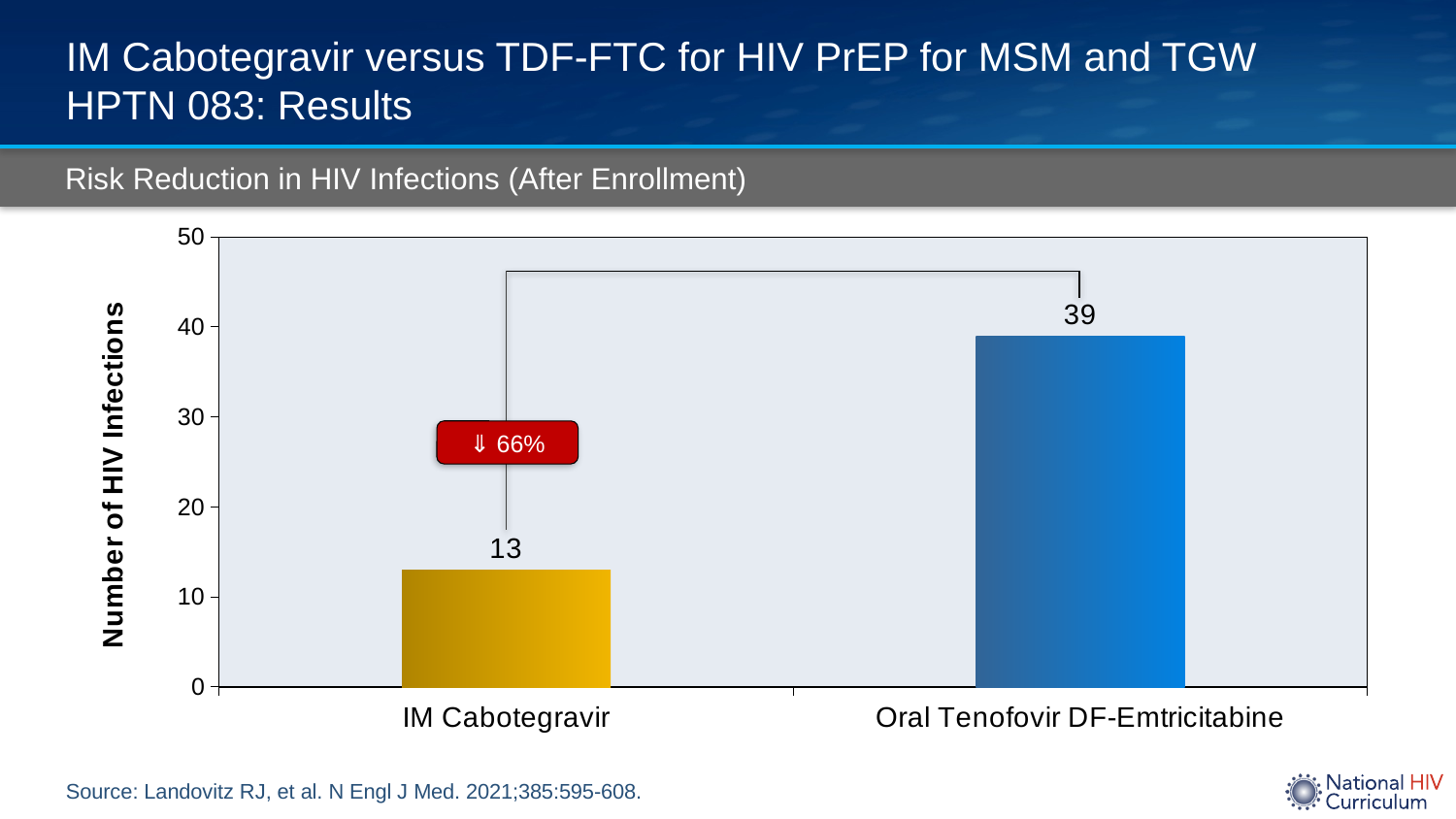
Is the number of HIV infections for IM Cabotegravir greater or less than 20? less What is the label of the y axis of the chart? Number of HIV Infections Which group had the highest number of HIV infections? Oral Tenofovir DF-Emtricitabine Which group had the lowest number of HIV infections? IM Cabotegravir Is the number of HIV infections for Oral Tenofovir DF-Emtricitabine greater or less than 30? greater What is the number of HIV infections for Oral Tenofovir DF-Emtricitabine? 39 What is the number of HIV infections for IM Cabotegravir? 13 How many categories are shown on the x axis of the chart? 2 What is the difference in the number of HIV infections between Oral Tenofovir DF-Emtricitabine and IM Cabotegravir? 26 Which had more HIV infections, IM Cabotegravir or Oral Tenofovir DF-Emtricitabine? Oral Tenofovir DF-Emtricitabine What kind of chart is shown on the slide? Bar chart What percentage risk reduction is shown in the red label on the chart? 66%